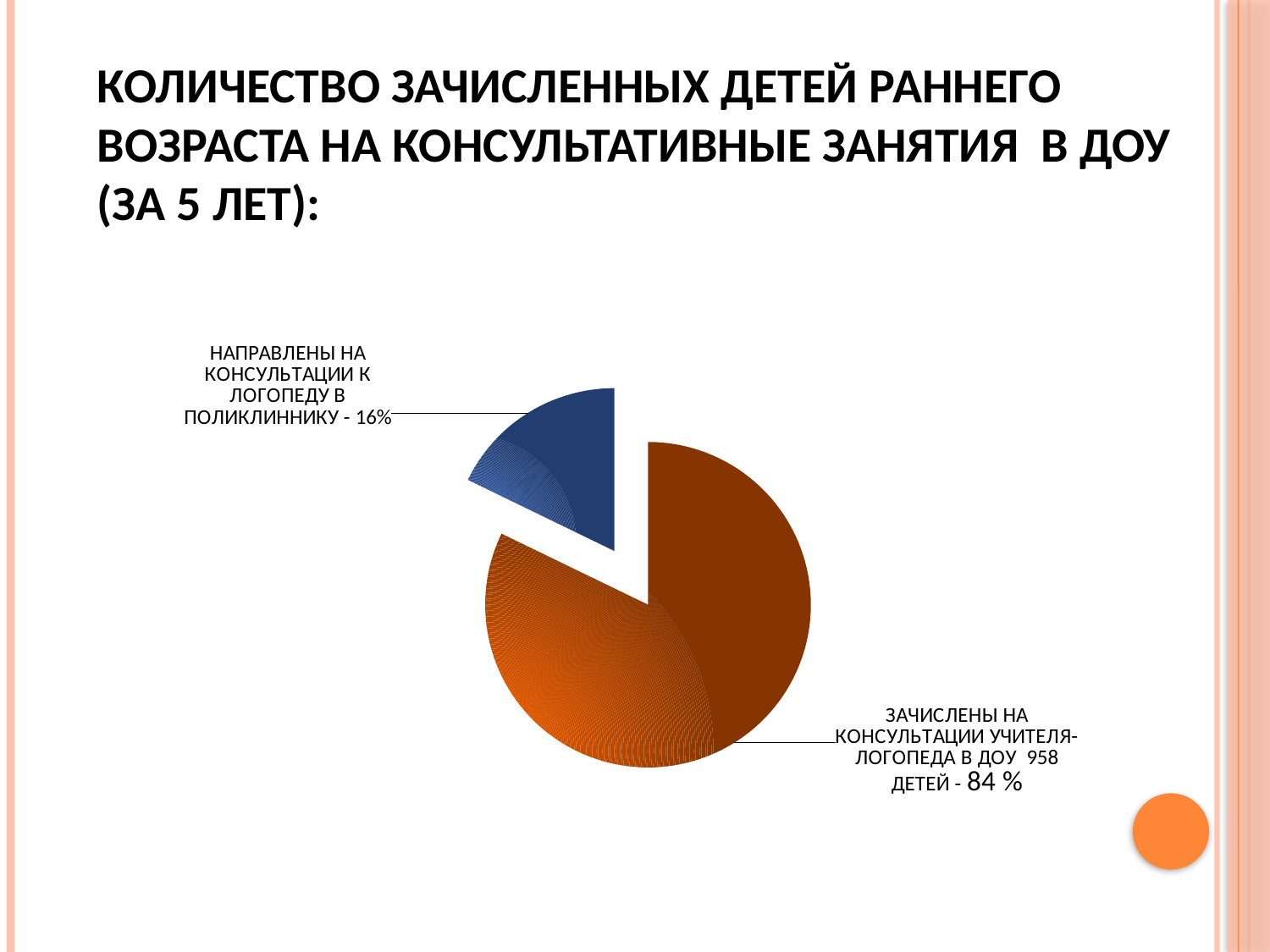
What share of the pie is labelled "ЗАЧИСЛЕНЫ НА КОНСУЛЬТАЦИИ УЧИТЕЛЯ-ЛОГОПЕДА В ДОУ"? 84 % What colour is the slice representing children enrolled with the DOU speech therapist (84 %)? Orange What colour is the slice representing children referred to the clinic speech therapist (16%)? Blue What share of the pie is labelled "НАПРАВЛЕНЫ НА КОНСУЛЬТАЦИИ К ЛОГОПЕДУ В ПОЛИКЛИННИКУ"? 16% Over how many years does the slide title say the data was collected? 5 лет Which slice of the pie chart is the largest? ЗАЧИСЛЕНЫ НА КОНСУЛЬТАЦИИ УЧИТЕЛЯ-ЛОГОПЕДА В ДОУ By how many percentage points does the DOU speech therapist share exceed the clinic referral share? 68 percentage points How many slices does the pie chart have? 2 How many children are stated as enrolled in consultations with the DOU speech therapist (учителя-логопеда в ДОУ)? 958 Which slice of the pie chart is the smallest? НАПРАВЛЕНЫ НА КОНСУЛЬТАЦИИ К ЛОГОПЕДУ В ПОЛИКЛИННИКУ What kind of chart is shown on the slide? Pie chart Which is larger: the share referred to the clinic speech therapist (поликлиннику) or the share enrolled with the DOU speech therapist? Enrolled with the DOU speech therapist (84 %)